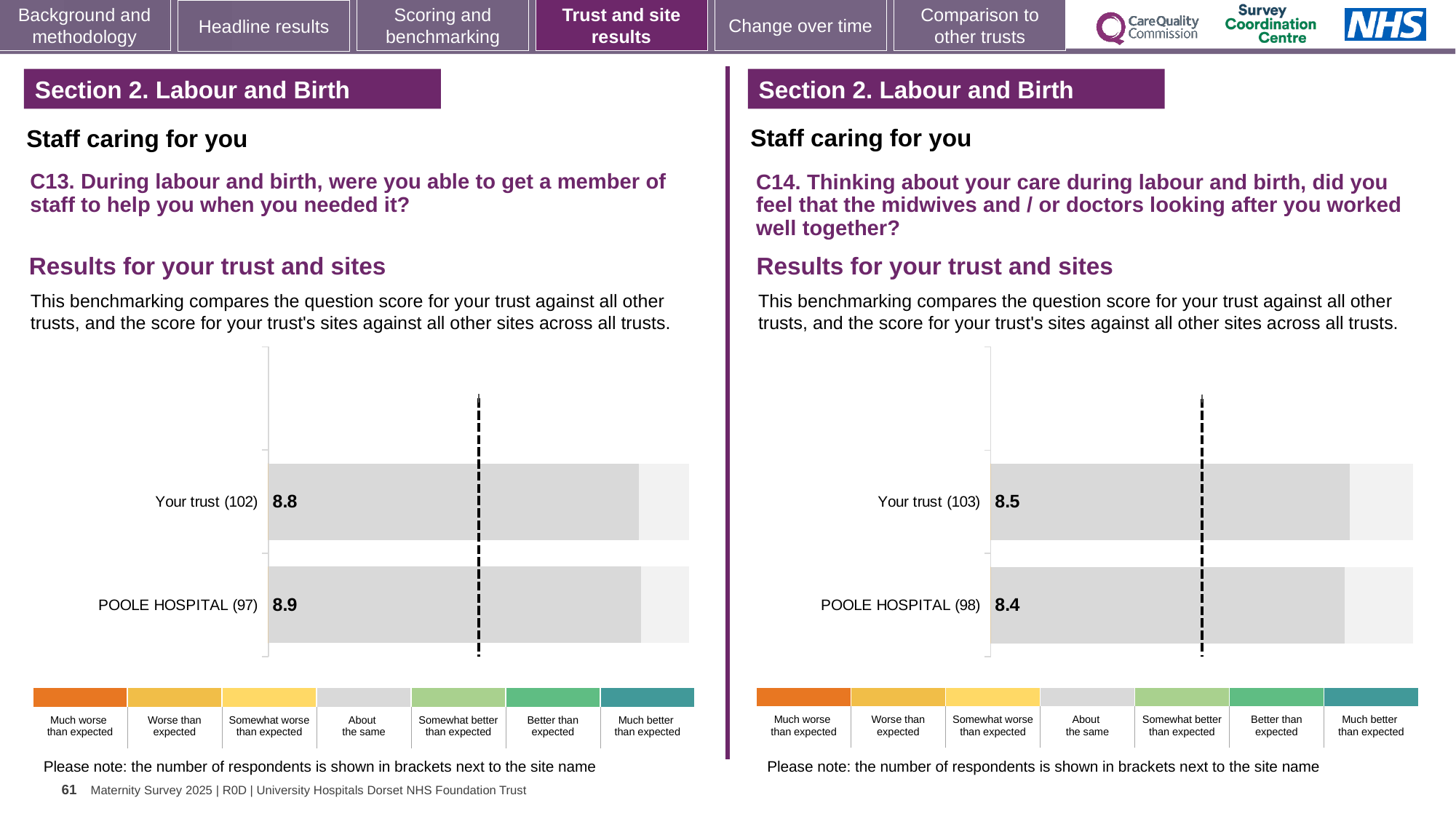
In the C13 chart on the left, which category has the higher score? POOLE HOSPITAL (97) In the C14 chart on the right, what is the difference between the Your trust (103) score and the POOLE HOSPITAL (98) score? 0.1 In the C13 chart on the left, what is the score for Your trust (102)? 8.8 What kind of chart is the C14 chart on the right? bar chart In the C13 chart on the left, how many rating bands are shown in the colour key below the chart? 7 In the C13 chart on the left, what is the difference between the POOLE HOSPITAL (97) score and the Your trust (102) score? 0.1 In the C14 chart on the right, what is the score for Your trust (103)? 8.5 In the C13 chart on the left, what is the score for POOLE HOSPITAL (97)? 8.9 In the C14 chart on the right, is the score for Your trust (103) larger or smaller than the score for POOLE HOSPITAL (98)? larger In the C14 chart on the right, which category has the lower score? POOLE HOSPITAL (98) How many categories are plotted in the C13 chart on the left? 2 In the C14 chart on the right, what is the score for POOLE HOSPITAL (98)? 8.4